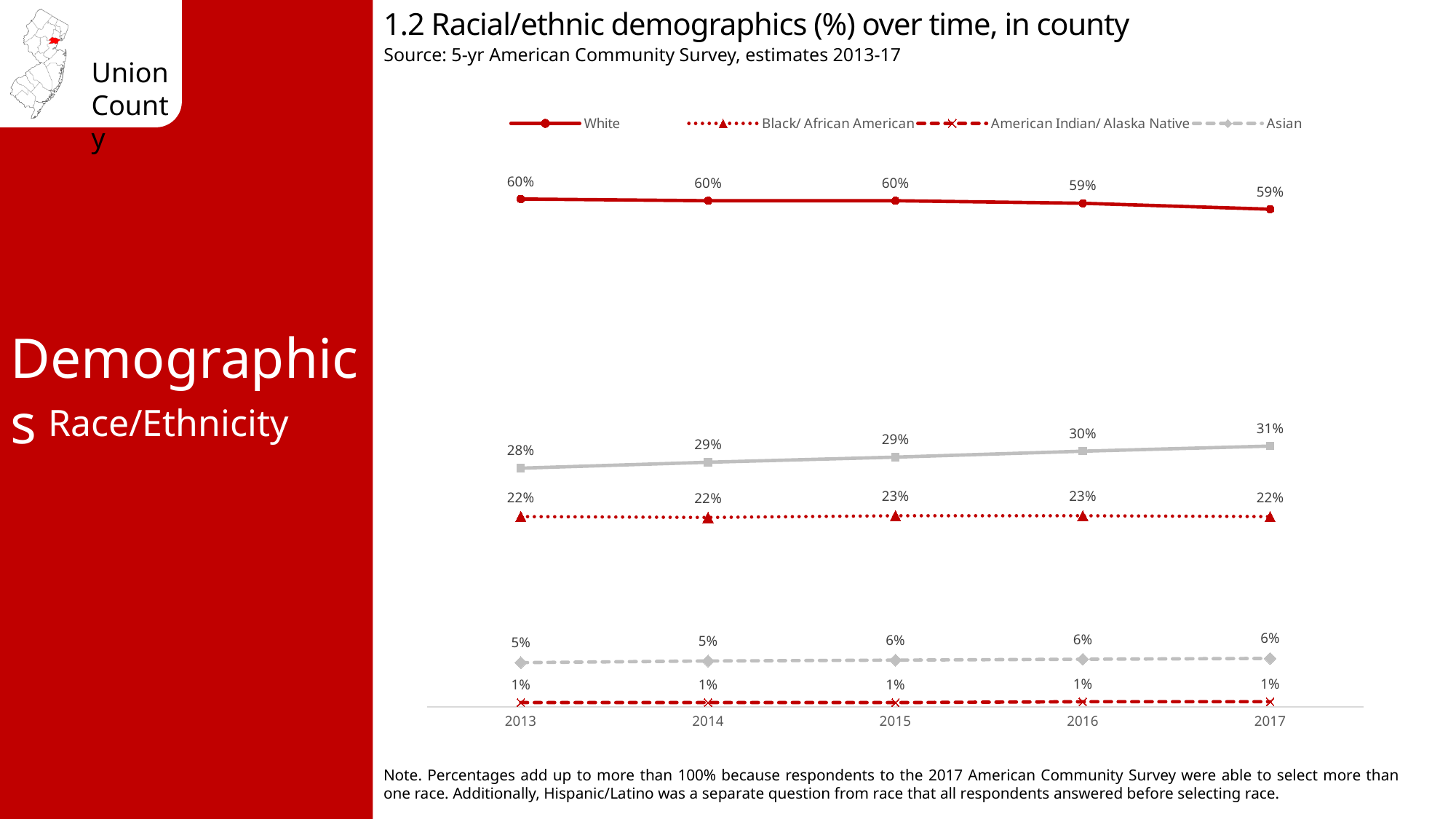
What was the White percentage in 2013? 60% Which series has the highest value in 2017? White What was the American Indian/ Alaska Native percentage in 2016? 1% What is the difference between the White and Black/ African American percentages in 2013? 38% Which series has the lowest value in 2013? American Indian/ Alaska Native Does the White percentage rise or fall from 2013 to 2017? Fall What type of chart is shown on the slide? Line chart What was the Asian percentage in 2014? 5% Which is larger in 2016, the Asian percentage or the Black/ African American percentage? Black/ African American What was the White percentage in 2017? 59% How many years are shown on the x axis? 5 What was the Black/ African American percentage in 2015? 23%